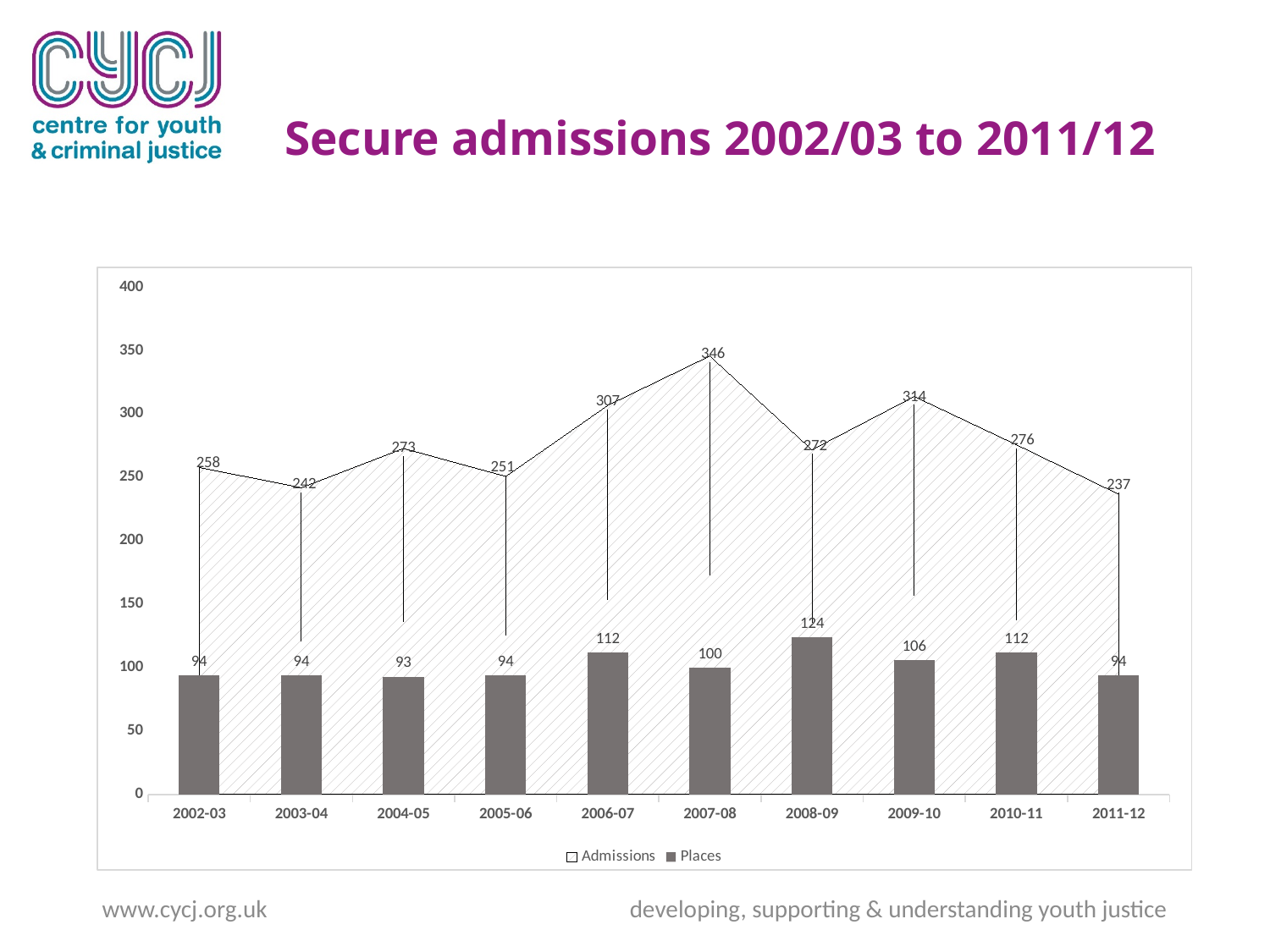
Which is larger, the Admissions value for 2009-10 or the Admissions value for 2010-11? 2009-10 What are the two series named in the legend? Admissions and Places How many years are shown on the x axis? 10 Which year has the highest Admissions value? 2007-08 Which year has the lowest Admissions value? 2011-12 Which year has the highest Places value? 2008-09 What is the Admissions value for 2011-12? 237 Do the Admissions values rise or fall from 2008-09 to 2009-10? rise How many series does the legend list? 2 What is the Admissions value for 2007-08? 346 What is the difference between Admissions in 2007-08 and Admissions in 2006-07? 39 What is the Places value for 2008-09? 124